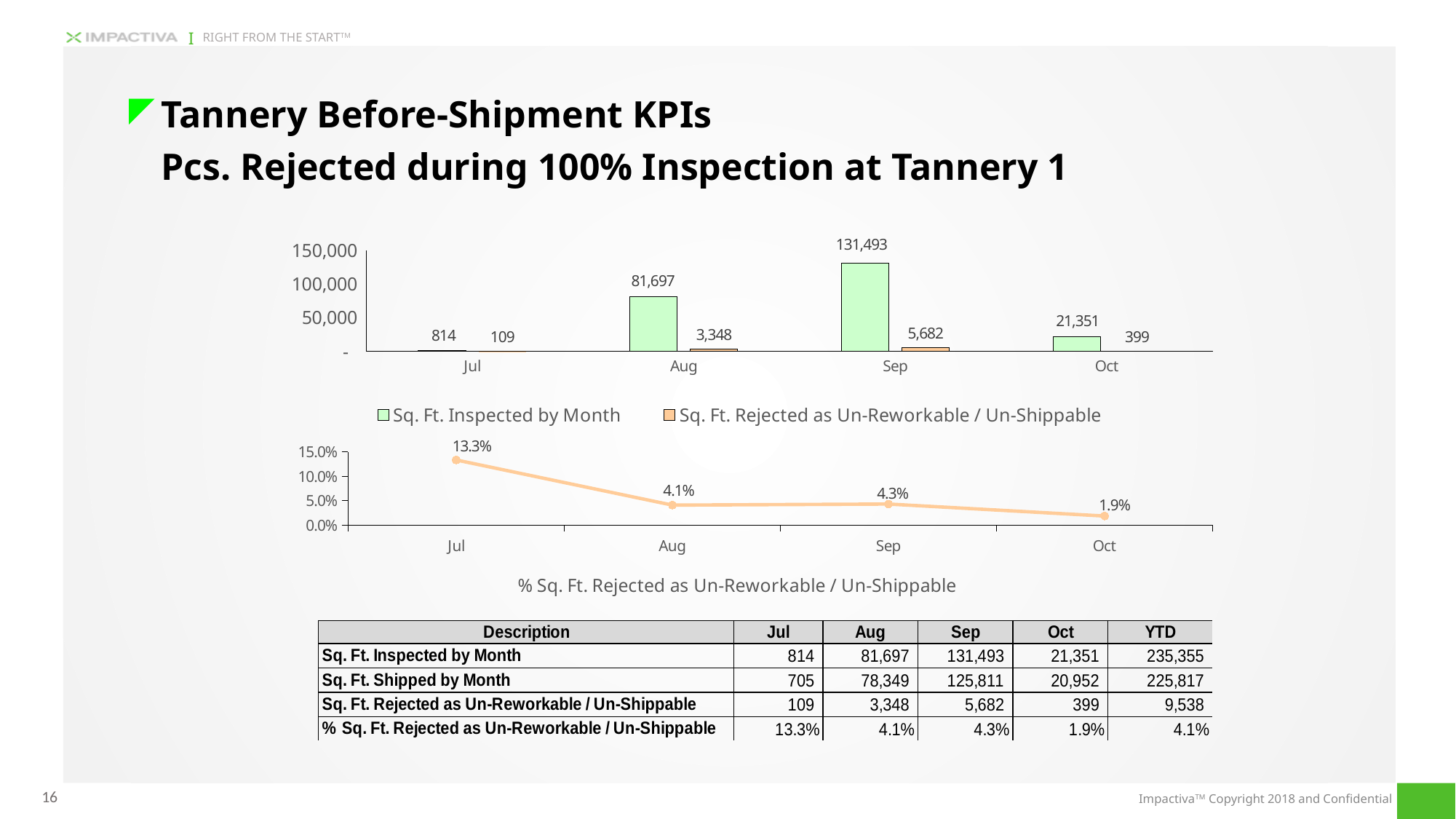
In the top bar chart, what is the value of Sq. Ft. Inspected by Month for Sep? 131,493 How many series does the legend of the top bar chart list? 2 In the bottom line chart, what is the % Sq. Ft. Rejected as Un-Reworkable / Un-Shippable for Jul? 13.3% In the top bar chart, is Sq. Ft. Inspected by Month larger in Oct or in Aug? Aug In the top bar chart, which month has the lowest Sq. Ft. Rejected as Un-Reworkable / Un-Shippable? Jul In the top bar chart, what is the value of Sq. Ft. Rejected as Un-Reworkable / Un-Shippable for Aug? 3,348 In the top bar chart, what is the difference between Sq. Ft. Inspected by Month in Sep and in Aug? 49,796 In the bottom line chart, which month has the lowest % Sq. Ft. Rejected as Un-Reworkable / Un-Shippable? Oct What kind of chart is the top chart on the slide? Bar chart In the top bar chart, which month has the highest Sq. Ft. Inspected by Month? Sep How many months are plotted on the x axis of the bottom line chart? 4 In the bottom line chart, does the % Sq. Ft. Rejected as Un-Reworkable / Un-Shippable generally rise or fall from Jul to Oct? Fall